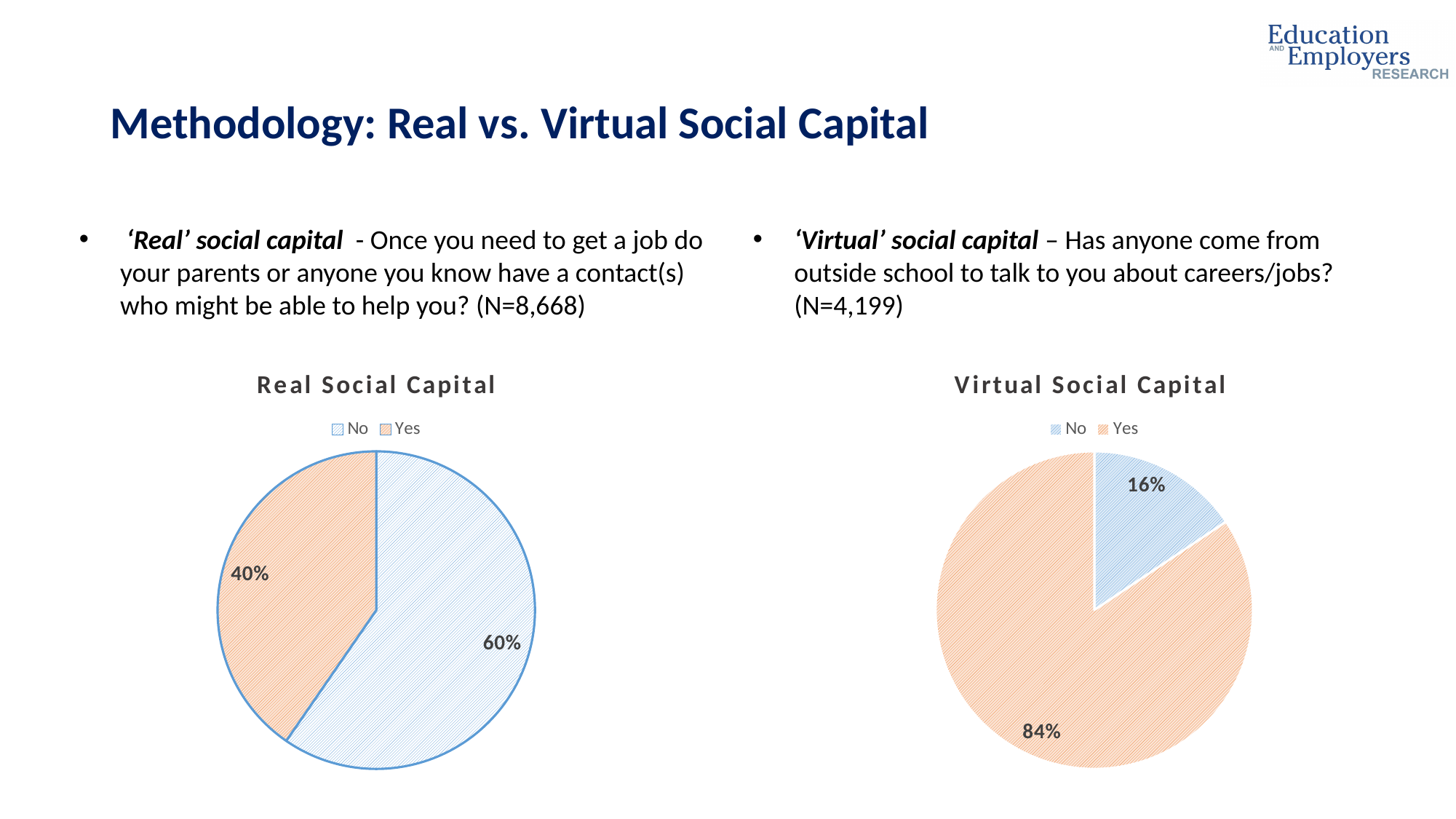
How many categories does the legend of the Virtual Social Capital chart list? 2 In the Virtual Social Capital chart, what is the difference between the Yes and No shares? 68 percentage points In the Virtual Social Capital chart, which response has the smaller share? No In the Virtual Social Capital chart, which colour represents Yes? Orange In the Real Social Capital chart, what percentage answered Yes? 40% Which is larger: the Yes share in the Real Social Capital chart or the Yes share in the Virtual Social Capital chart? Virtual Social Capital In the Virtual Social Capital chart, what percentage answered No? 16% In the Real Social Capital chart, which response has the larger share? No In the Real Social Capital chart, what percentage answered No? 60% In the Virtual Social Capital chart, what percentage answered Yes? 84% What type of chart is the Real Social Capital chart? Pie chart In the Real Social Capital chart, what is the difference between the No and Yes shares? 20 percentage points